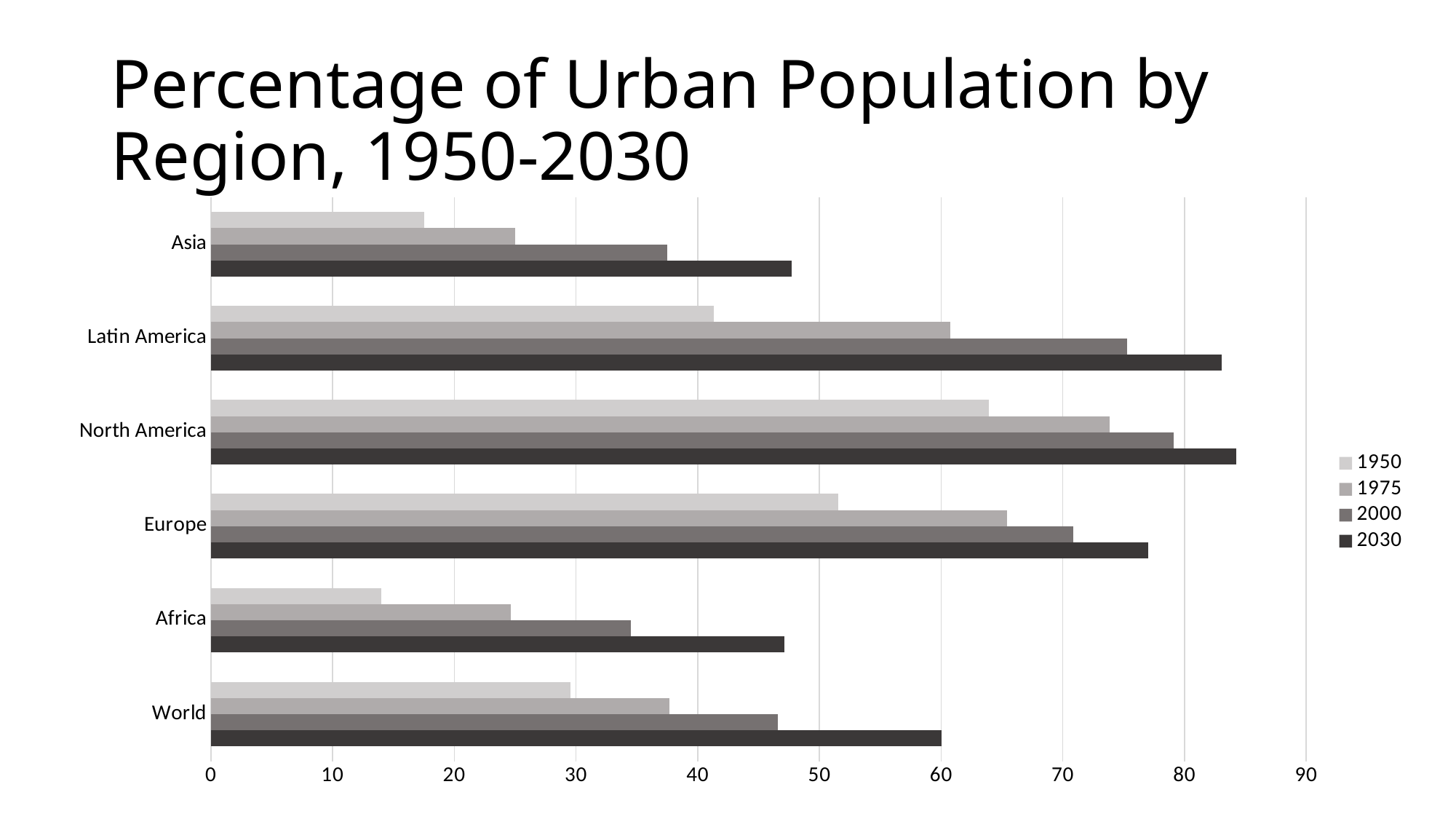
Do the values for Asia increase or decrease from 1950 to 2030? increase Which region has the highest value for 1950? North America Is the value for World in 2000 greater or less than 50? less What kind of chart is shown on the slide? bar chart How many regions are shown on the chart? 6 Which is larger, the 2030 value for Europe or the 2030 value for Latin America? Latin America How many series does the legend list? 4 Is the value for Africa in 1950 greater or less than 20? less What is the title of the chart? Percentage of Urban Population by Region, 1950-2030 Is the value for Asia in 2030 greater or less than 50? less Which region has the lowest value for 1950? Africa